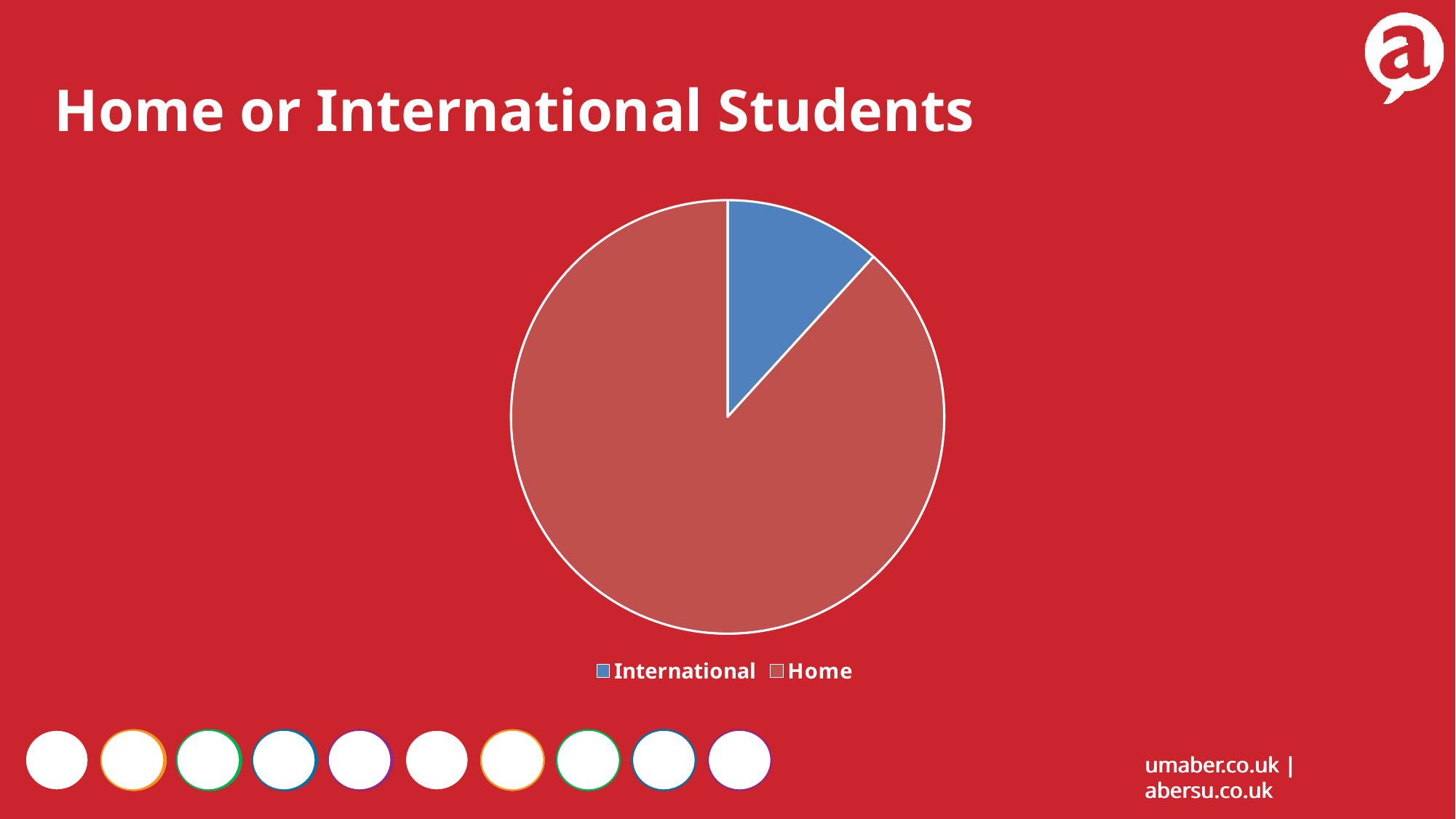
Which category has the smallest slice of the pie chart? International Which category has the largest slice of the pie chart? Home Does the Home slice take up more or less than half of the pie chart? more How many slices does the pie chart have? 2 What kind of chart is shown on the slide? pie chart What is the title of the chart on the slide? Home or International Students How many entries does the legend of the pie chart list? 2 What colour is the International slice in the pie chart? blue Which slice is larger, International or Home? Home